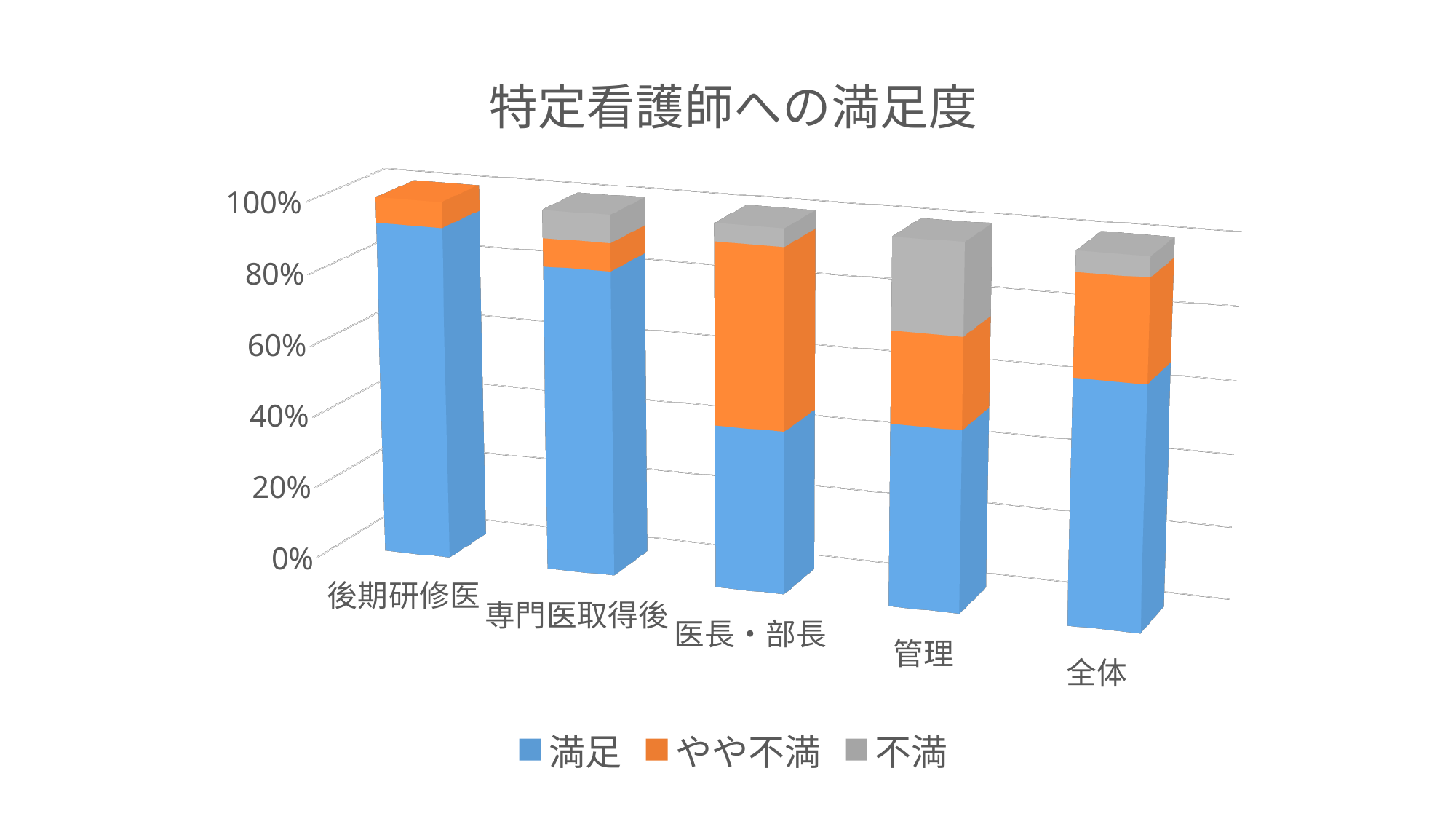
Is the 満足 value for 後期研修医 greater or less than 80%? greater Is the 満足 value for 専門医取得後 greater or less than 60%? greater What is the title of the chart? 特定看護師への満足度 How many categories are shown on the x axis? 5 Which has a larger やや不満 segment, 医長・部長 or 専門医取得後? 医長・部長 Which category has the largest 不満 segment? 管理 What kind of chart is shown on the slide? bar chart Which has a larger 満足 share, 後期研修医 or 全体? 後期研修医 How many series does the legend list? 3 Is the 満足 value for 医長・部長 greater or less than 60%? less Which legend entry is shown in gray? 不満 Which category has the highest 満足 share? 後期研修医